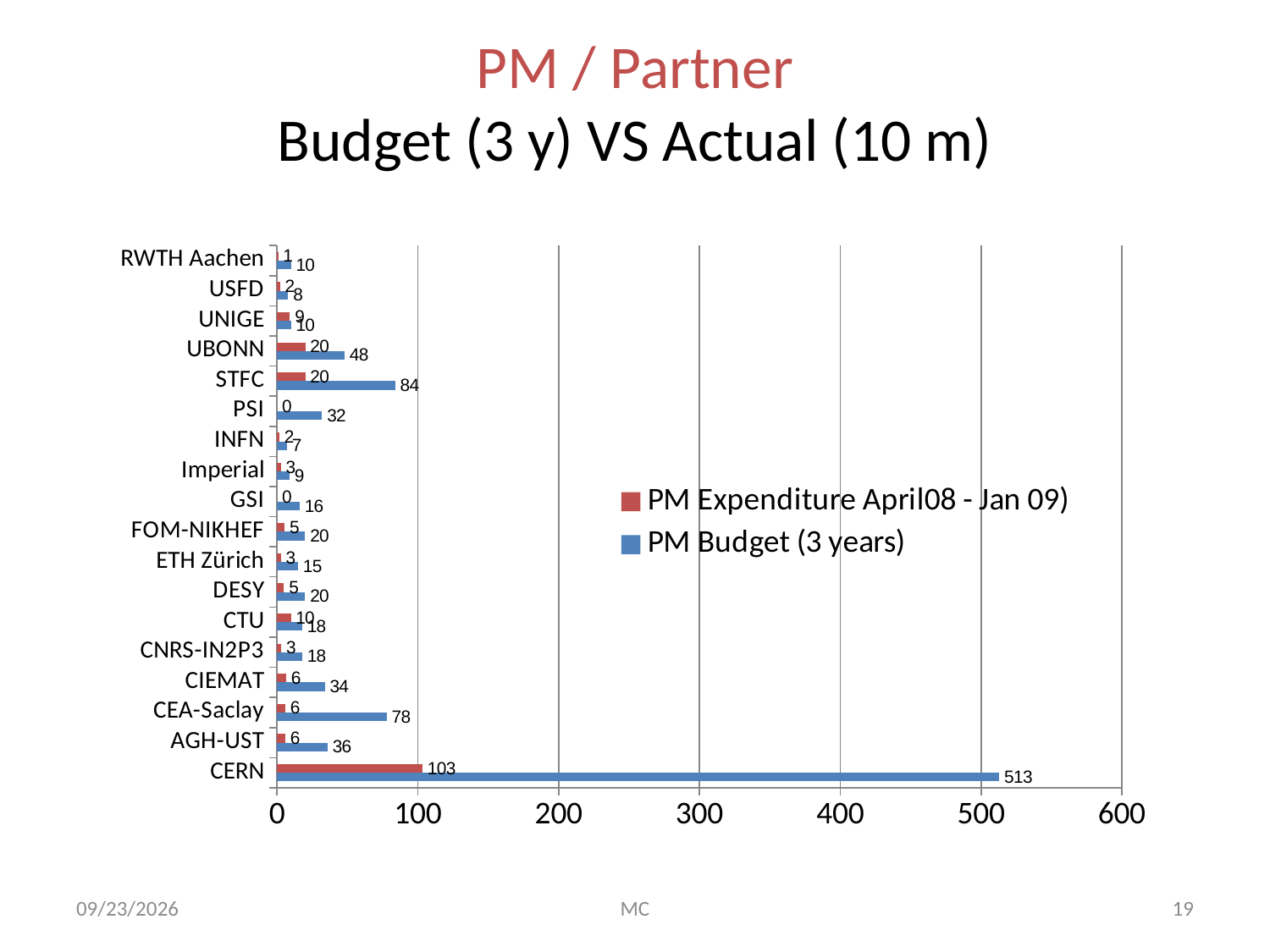
Which has a larger PM Budget (3 years), AGH-UST or CIEMAT? AGH-UST What is the difference between the PM Budget (3 years) and the PM Expenditure for CERN? 410 What is the PM Budget (3 years) value for CERN? 513 What is the PM Budget (3 years) value for CEA-Saclay? 78 Is the PM Budget (3 years) value for CERN greater or less than 500? greater How many partners are shown on the chart? 18 Which partner has the highest PM Budget (3 years)? CERN How many series does the legend list? 2 What is the difference between the PM Budget (3 years) values for STFC and UBONN? 36 Which partner has the lowest PM Budget (3 years)? INFN What is the PM Expenditure April08 - Jan 09) value for STFC? 20 What kind of chart is shown on the slide? Bar chart